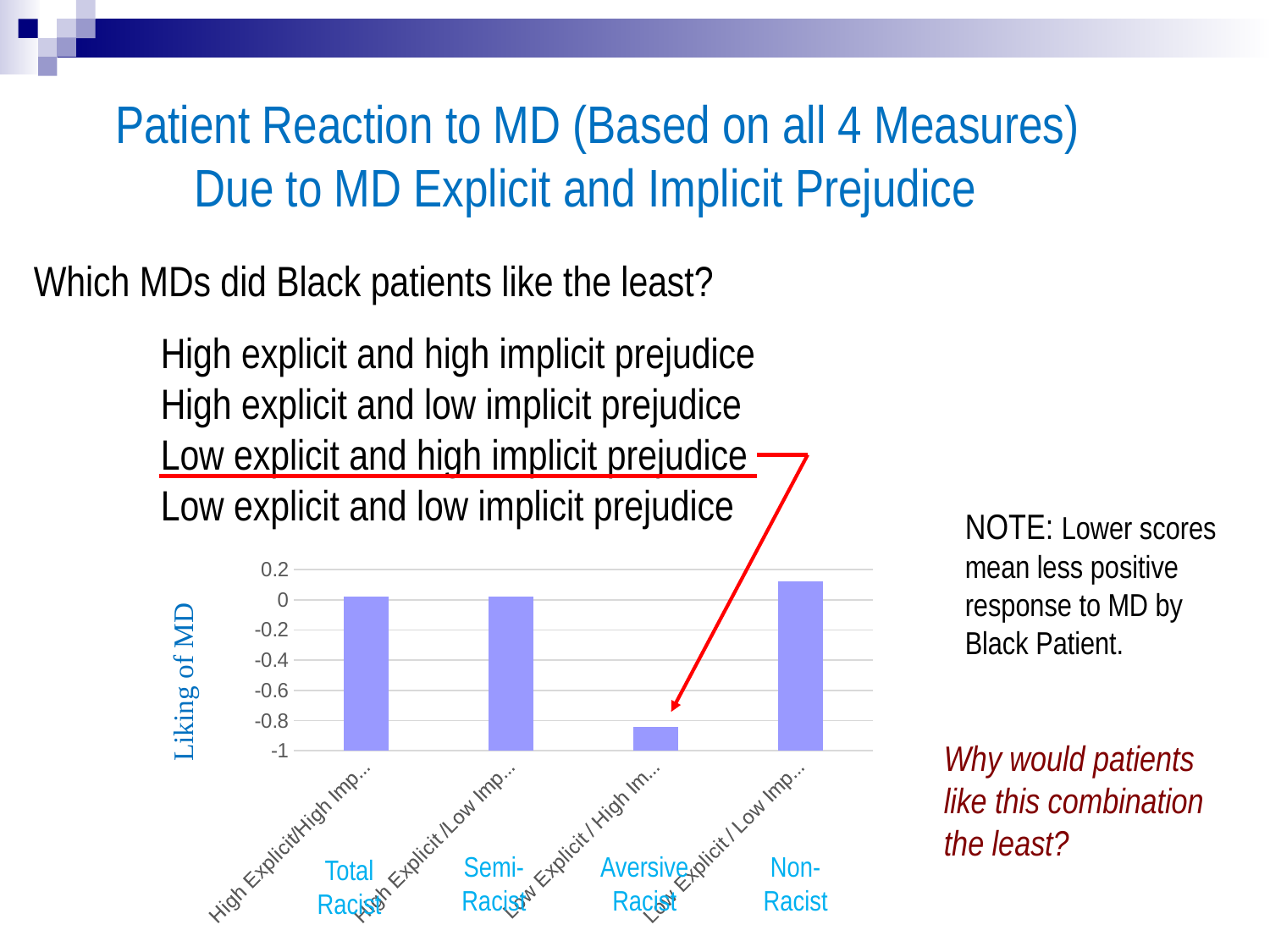
Which is larger, the value for Semi-Racist or the value for Aversive Racist? Semi-Racist Which category has the highest Liking of MD value? Non-Racist (Low Explicit / Low Implicit) Is the value for Total Racist greater or less than 0.2? less Which is larger, the value for Aversive Racist or the value for Non-Racist? Non-Racist Is the value for Semi-Racist greater or less than -0.2? greater What kind of chart is shown on the slide? bar chart How many bars (categories) does the chart show? 4 Is the value for Aversive Racist greater or less than -0.6? less What is the title of the vertical axis of the chart? Liking of MD What is the lowest tick value shown on the vertical axis? -1 Which category has the lowest Liking of MD value? Aversive Racist (Low Explicit / High Implicit)